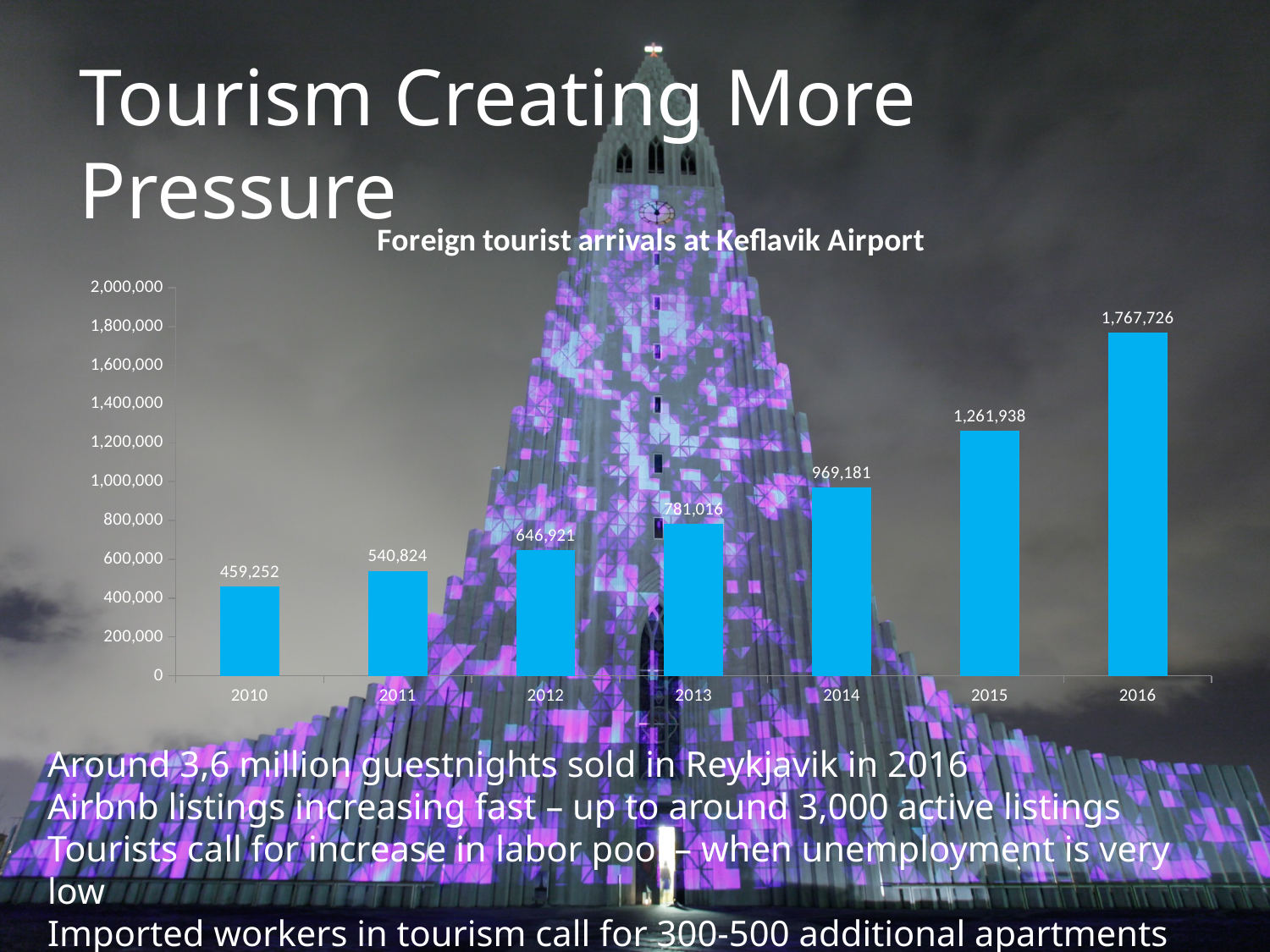
What is the value for 2015 in the chart? 1,261,938 What is the value for 2013 in the chart? 781,016 Do the values rise or fall from 2010 to 2016? Rise Is the value for 2015 greater or less than 1,200,000? greater How many years are shown on the x axis of the chart? 7 What is the difference between the values for 2014 and 2013? 188,165 What is the difference between the values for 2016 and 2015? 505,788 What kind of chart is shown on the slide? Bar chart What is the value for 2010 in the chart? 459,252 Which year has the lowest number of foreign tourist arrivals? 2010 Which year has the highest number of foreign tourist arrivals? 2016 Which is larger, the value for 2012 or the value for 2014? 2014